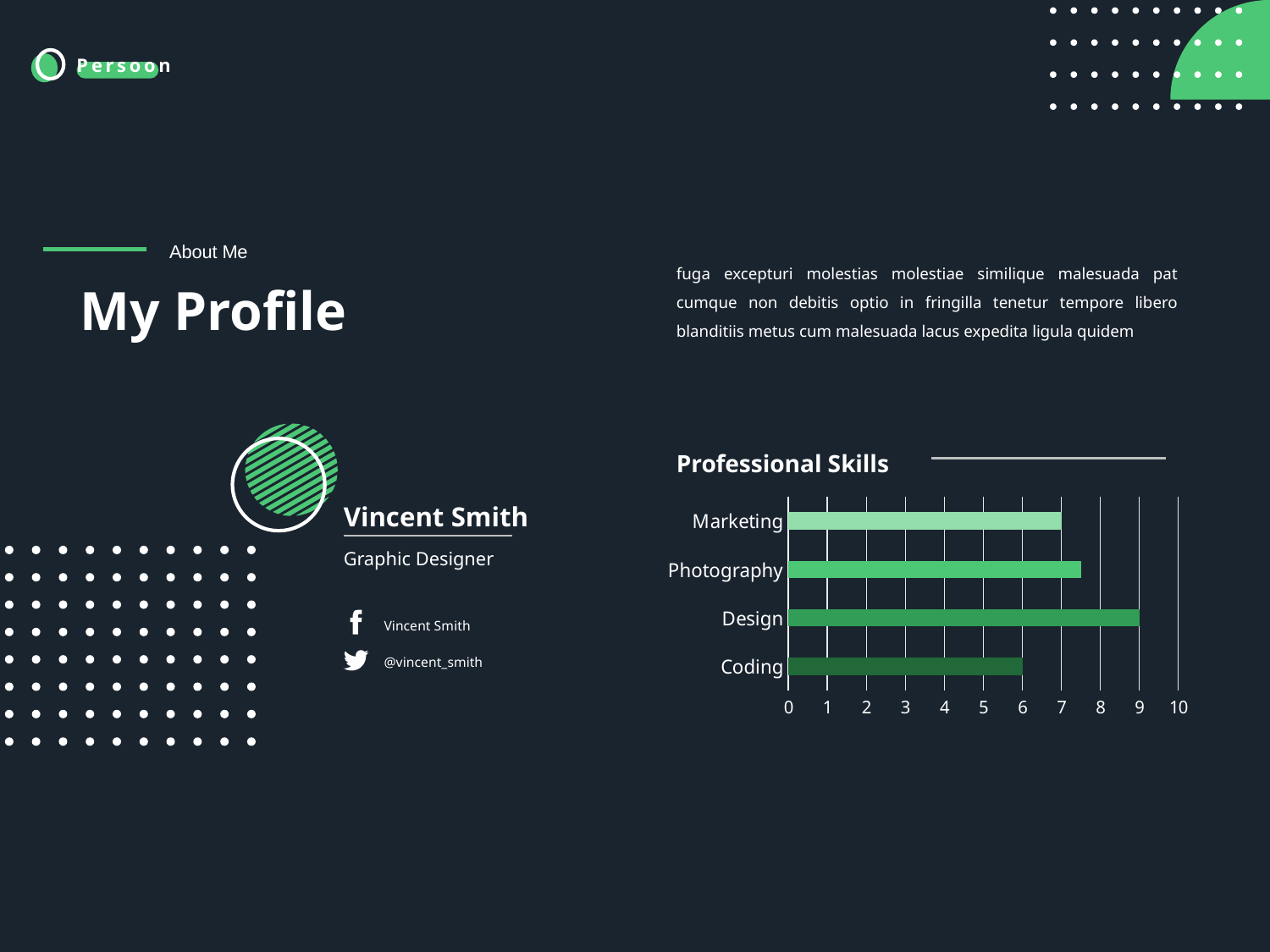
What type of chart is shown under the heading Professional Skills? bar chart What is the value for Design in the Professional Skills chart? 9 How many skill categories are plotted in the Professional Skills chart? 4 What is the value for Coding in the Professional Skills chart? 6 Is the value for Photography in the Professional Skills chart greater or less than 8? less What is the title of the chart on the slide? Professional Skills Which is larger in the Professional Skills chart, the value for Design or the value for Marketing? Design Which skill has the lowest value in the Professional Skills chart? Coding Which skill has the highest value in the Professional Skills chart? Design What is the value for Marketing in the Professional Skills chart? 7 Is the value for Photography in the Professional Skills chart greater or less than 7? greater What is the difference between the values for Design and Coding in the Professional Skills chart? 3